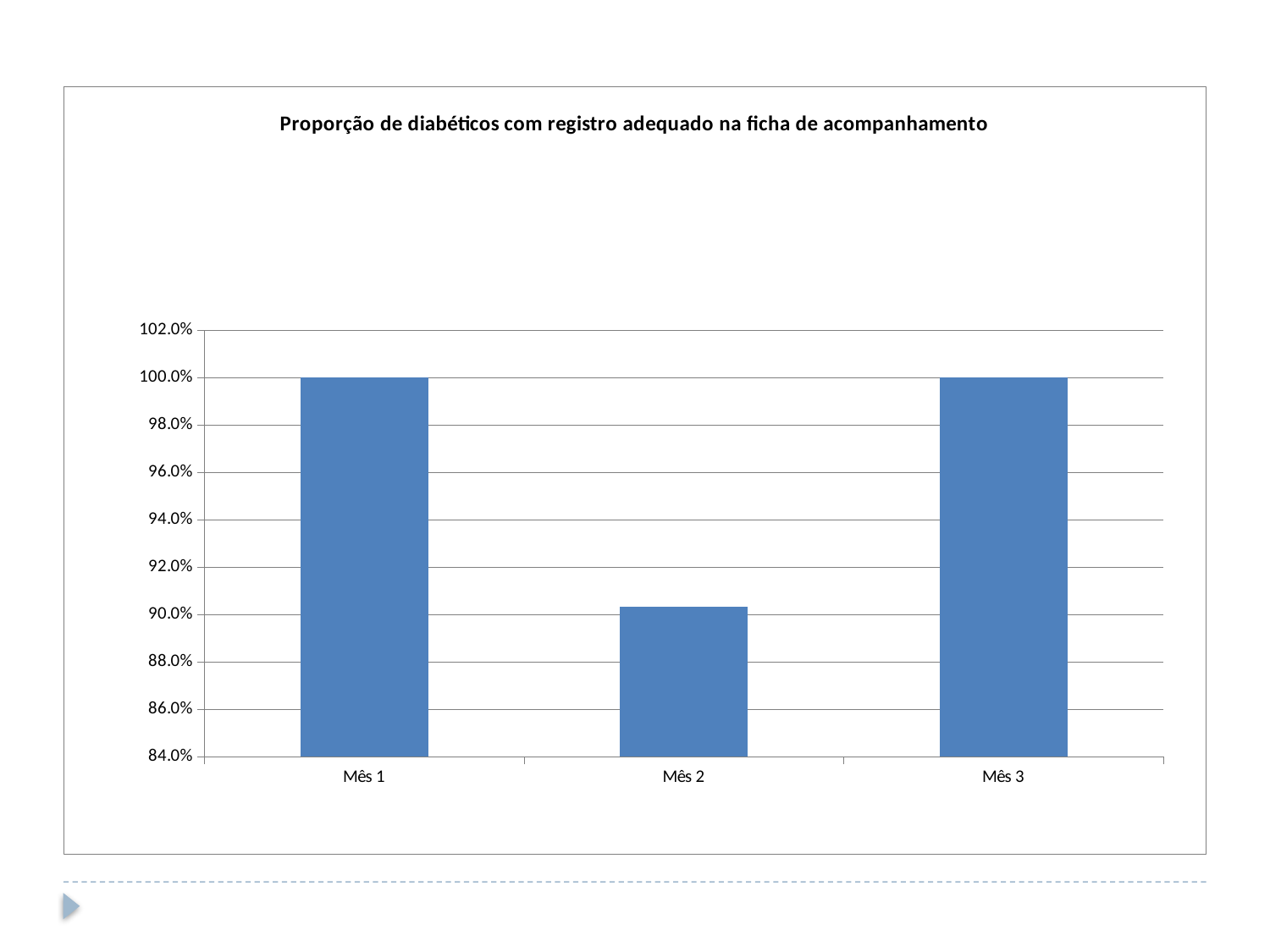
Which is larger, the value for Mês 1 or the value for Mês 2? Mês 1 What kind of chart is shown on the slide? bar chart How many categories are shown on the x axis? 3 What is the difference between the values for Mês 1 and Mês 3? 0.0% Do the values rise or fall from Mês 1 to Mês 2? fall Is the value for Mês 2 greater or less than 88.0%? greater What is the highest value shown on the y axis? 102.0% What is the title of the chart? Proporção de diabéticos com registro adequado na ficha de acompanhamento What is the value for Mês 3? 100.0% What is the value for Mês 1? 100.0% Is the value for Mês 2 greater or less than 92.0%? less Which month has the lowest value? Mês 2